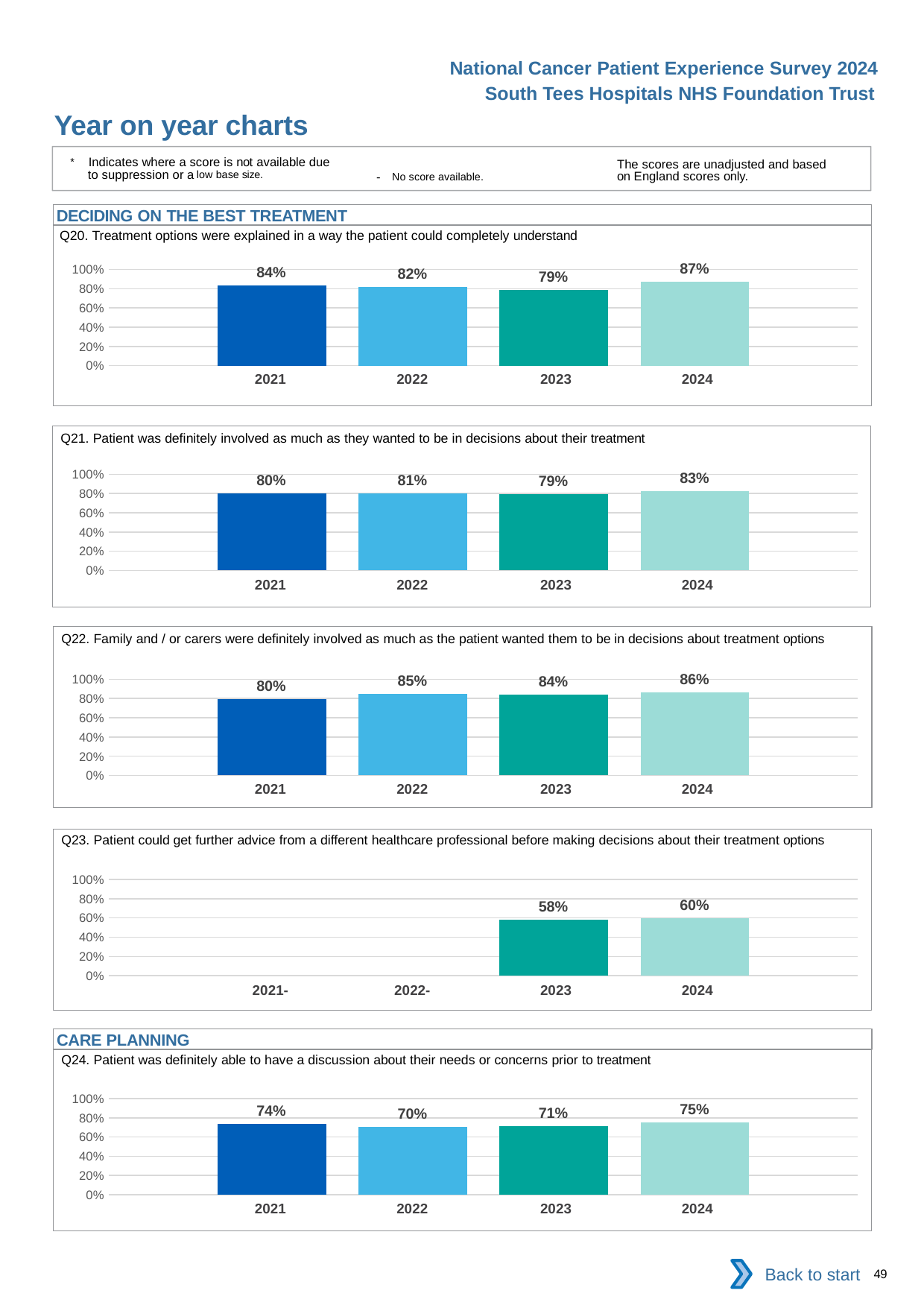
In the Q23 chart, is the value for 2024 greater or less than 80%? less In the Q24 chart, what is the difference between the 2024 and 2023 values? 4% In the Q22 chart (Family and / or carers were definitely involved as much as the patient wanted them to be), what is the difference between the 2024 and 2021 values? 6% In the Q21 chart (Patient was definitely involved as much as they wanted to be in decisions about their treatment), what is the value for 2022? 81% In the Q23 chart, how many years have a bar plotted? 2 In the Q22 chart, which is larger, the value for 2022 or the value for 2023? 2022 What kind of chart is used for Q20? Bar chart In the Q20 chart (Treatment options were explained in a way the patient could completely understand), what is the value for 2024? 87% In the Q23 chart (Patient could get further advice from a different healthcare professional), what is the value for 2023? 58% In the Q21 chart, which year has the highest value? 2024 In the Q24 chart (Patient was definitely able to have a discussion about their needs or concerns prior to treatment), what is the value for 2022? 70% In the Q20 chart, which year has the lowest value? 2023